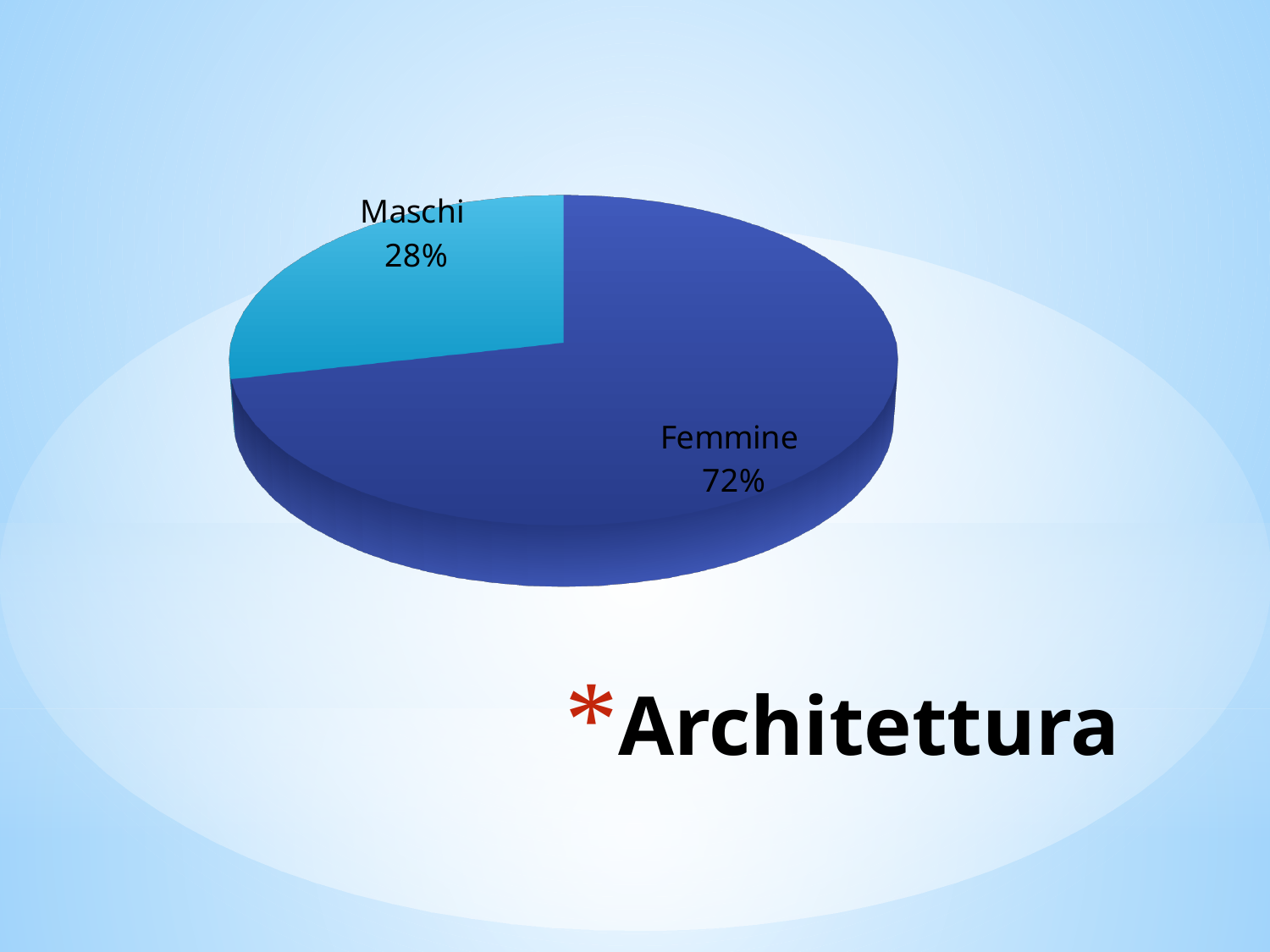
What share of the pie does the Maschi slice represent? 28% What kind of chart is shown on the slide? Pie chart What is the text shown below the pie chart on the slide? Architettura Which slice of the pie chart is the smallest? Maschi What percentage of the pie chart is Femmine? 72% What colour is the Femmine slice of the pie chart? Dark blue What percentage of the pie chart is Maschi? 28% Which slice of the pie chart is the largest? Femmine How many slices does the pie chart have? 2 Which slice is larger, Maschi or Femmine? Femmine What is the difference in percentage points between the Femmine and Maschi slices? 44